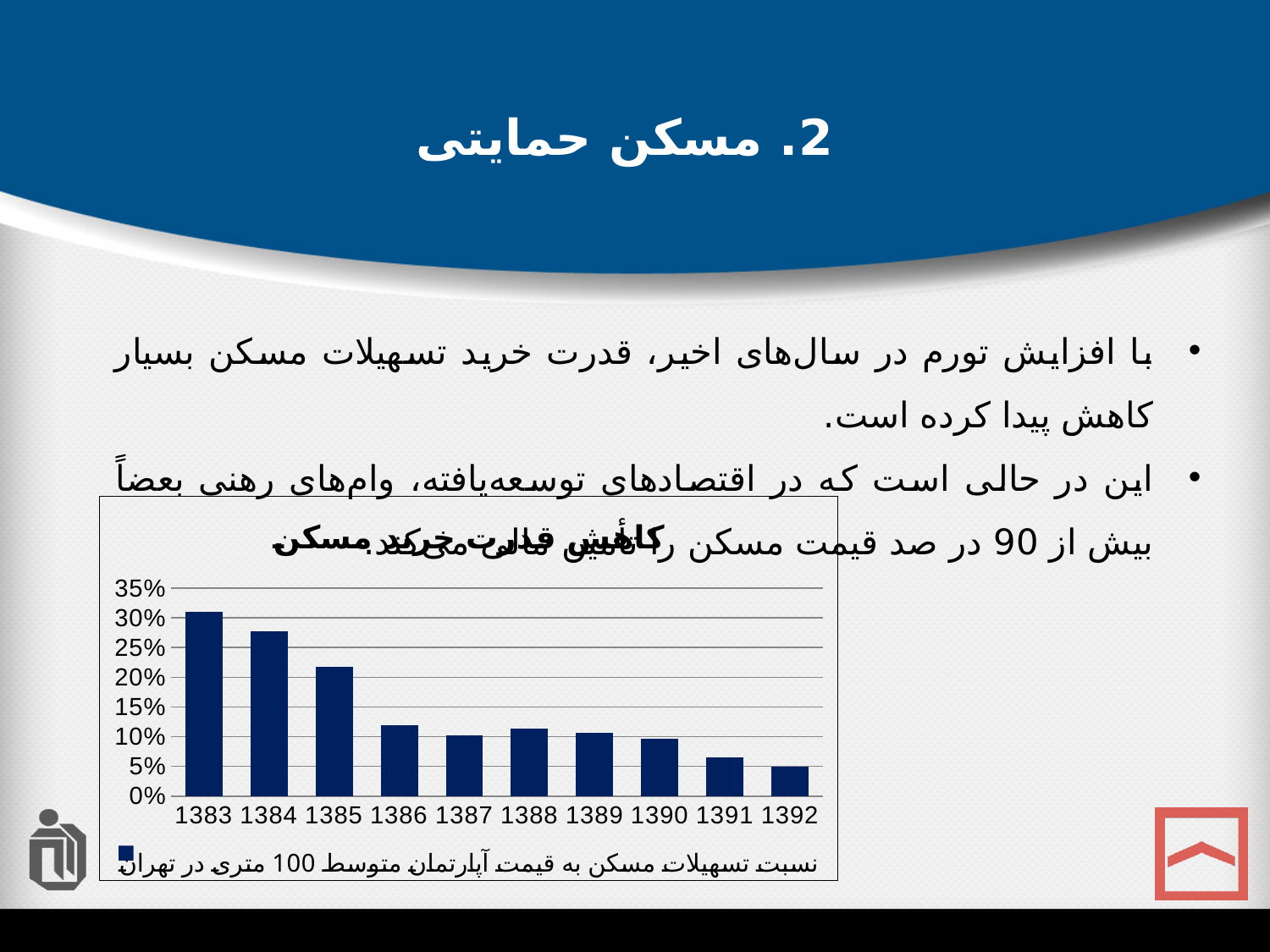
How many series does the chart's legend list? 1 What is the first year shown on the x axis of the chart? 1383 Is the value for 1383 greater or less than 25%? greater Is the value for 1385 greater or less than 20%? greater Do the values generally rise or fall from 1383 to 1392? fall Which is larger, the value for 1385 or the value for 1386? 1385 How many years are shown on the x axis of the chart? 10 Is the value for 1392 greater or less than 10%? less What kind of chart is shown on the slide? bar chart Which year has the highest value in the chart? 1383 Which year has the lowest value in the chart? 1392